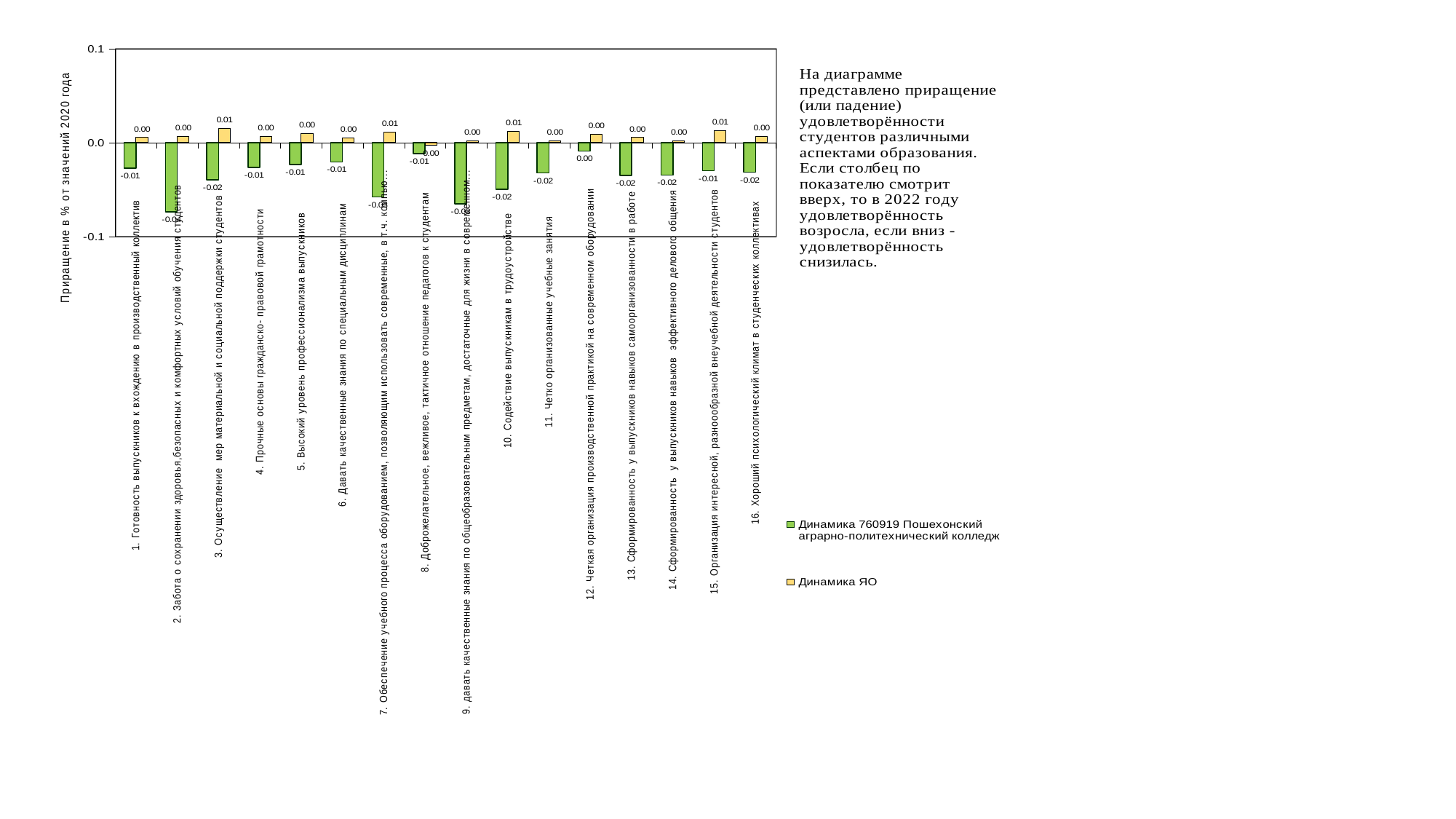
What is the value of the series 'Динамика ЯО' for category '15. Организация интересной, разнообразной внеучебной деятельности студентов'? 0.01 What is the value of the series 'Динамика 760919 Пошехонский аграрно-политехнический колледж' for category '10. Содействие выпускникам в трудоустройстве'? -0.02 What is the value of the series 'Динамика 760919 Пошехонский аграрно-политехнический колледж' for category '11. Четко организованные учебные занятия'? -0.02 What is the value of the series 'Динамика ЯО' for category '10. Содействие выпускникам в трудоустройстве'? 0.01 What is the value of the series 'Динамика 760919 Пошехонский аграрно-политехнический колледж' for category '5. Высокий уровень профессионализма выпускников'? -0.01 How many series does the chart legend list? 2 How many categories are plotted along the x axis of the chart? 16 What is the title of the vertical axis of the chart? Приращение в % от значений 2020 года For category '3. Осуществление мер материальной и социальной поддержки студентов', which series has the larger value: 'Динамика ЯО' or 'Динамика 760919 Пошехонский аграрно-политехнический колледж'? Динамика ЯО Which category has the lowest value for the series 'Динамика 760919 Пошехонский аграрно-политехнический колледж'? 2. Забота о сохранении здоровья, безопасных и комфортных условий обучения студентов What kind of chart is shown on the slide? Bar chart What is the difference between the 'Динамика ЯО' value and the 'Динамика 760919 Пошехонский аграрно-политехнический колледж' value for category '10. Содействие выпускникам в трудоустройстве'? 0.03